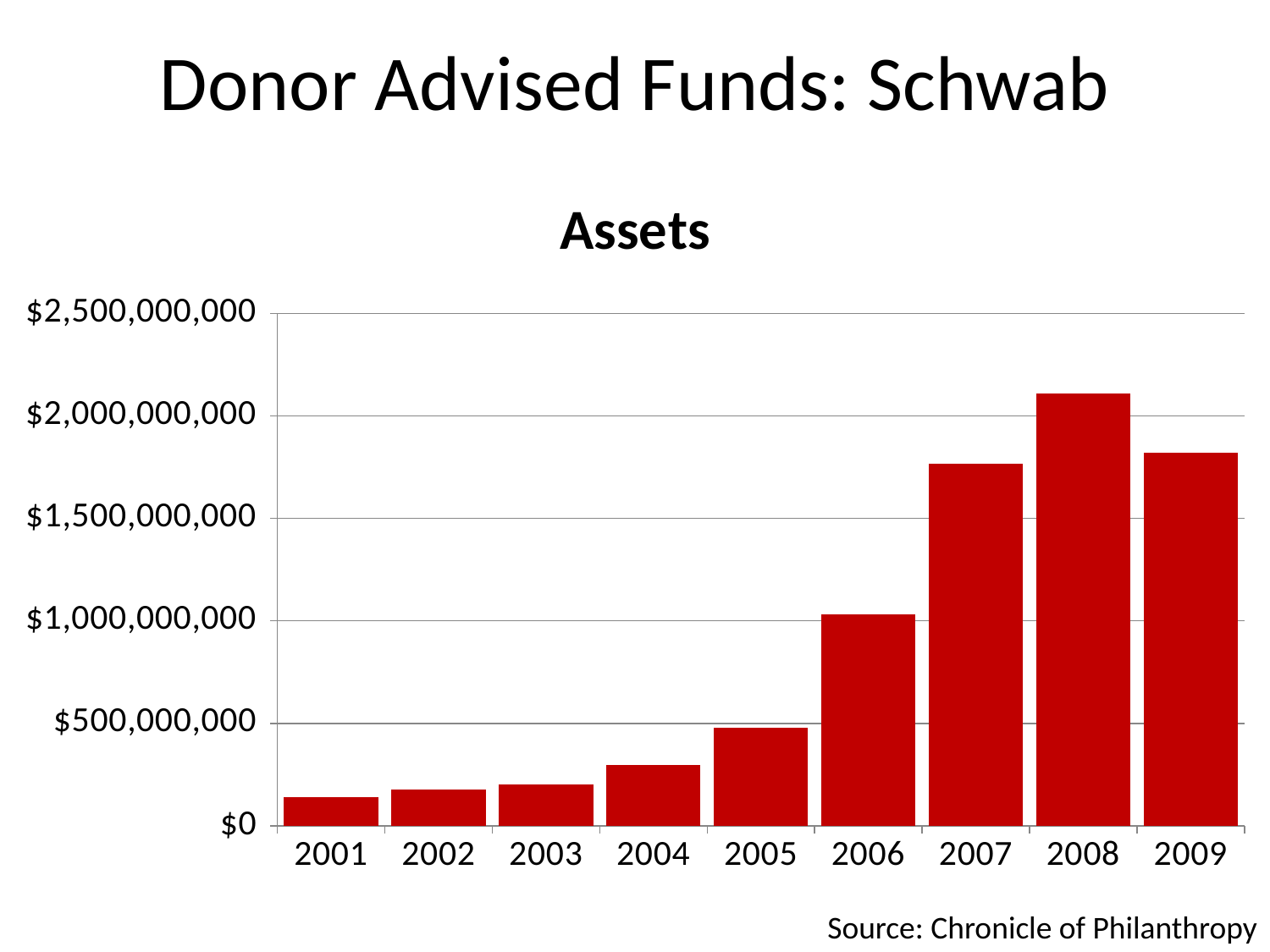
What kind of chart is shown on the slide? bar chart What is the title of the chart? Assets Which year has higher assets, 2005 or 2006? 2006 Is the value for 2009 greater or less than $2,000,000,000? less Is the value for 2007 greater or less than $1,500,000,000? greater Which year has the lowest assets? 2001 How many years are shown on the x axis of the chart? 9 Is the value for 2004 greater or less than $500,000,000? less Which year has higher assets, 2008 or 2009? 2008 Which year has the highest assets? 2008 Do assets rise or fall from 2001 to 2008? rise